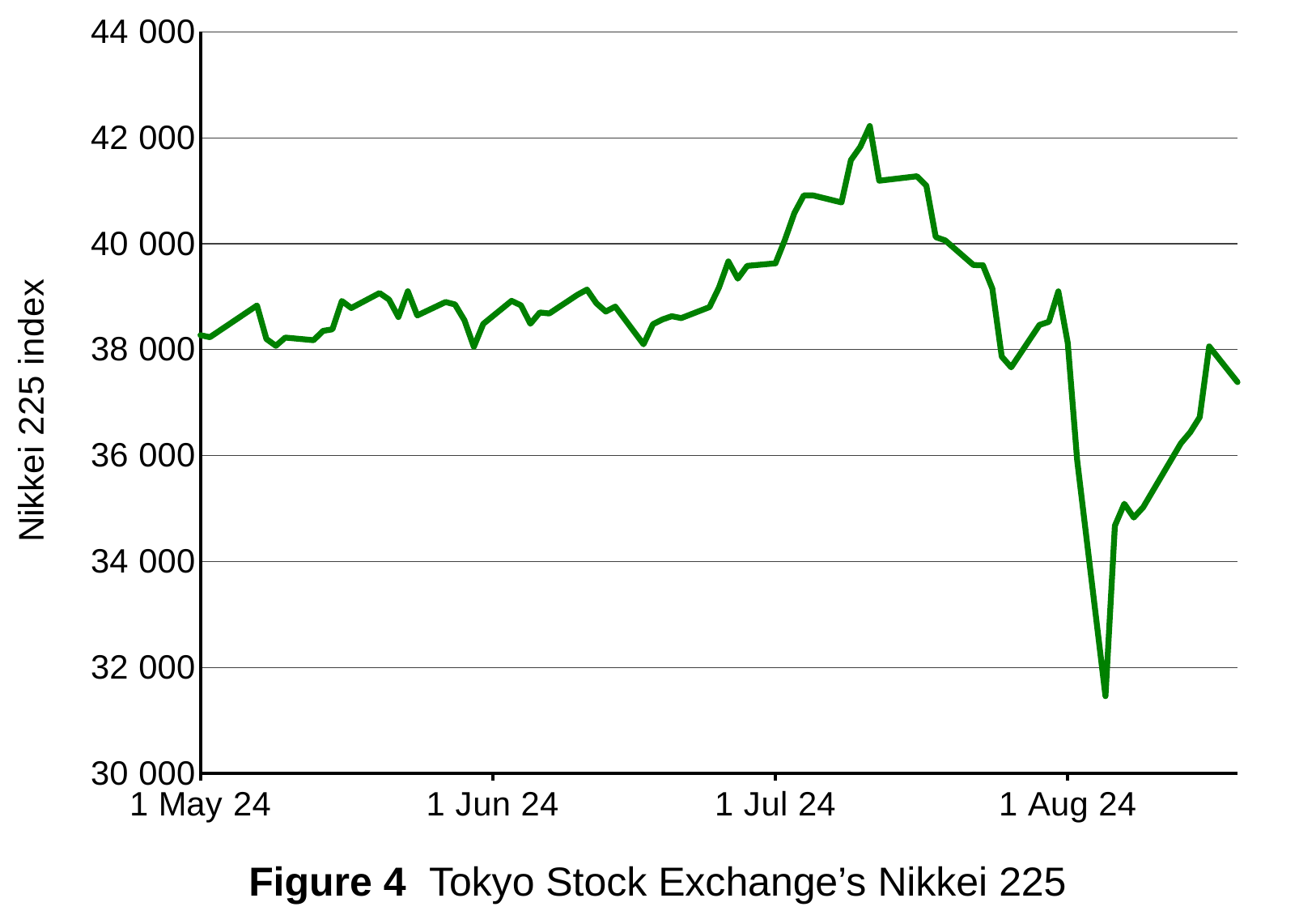
Is the value at the end of the series (mid-August 2024) greater or less than 36 000? greater Is the value on 1 May 24 greater or less than 40 000? less Is the lowest point of the line, reached in early August 2024, greater or less than 32 000? less Does the Nikkei 225 index rise or fall between 1 Jun 24 and its mid-July 2024 peak? rise Does the Nikkei 225 index rise or fall between its mid-July 2024 peak and its early August 2024 low? fall What is the title of the figure? Figure 4 Tokyo Stock Exchange's Nikkei 225 What kind of chart is shown in Figure 4? line chart What is the label on the vertical axis? Nikkei 225 index